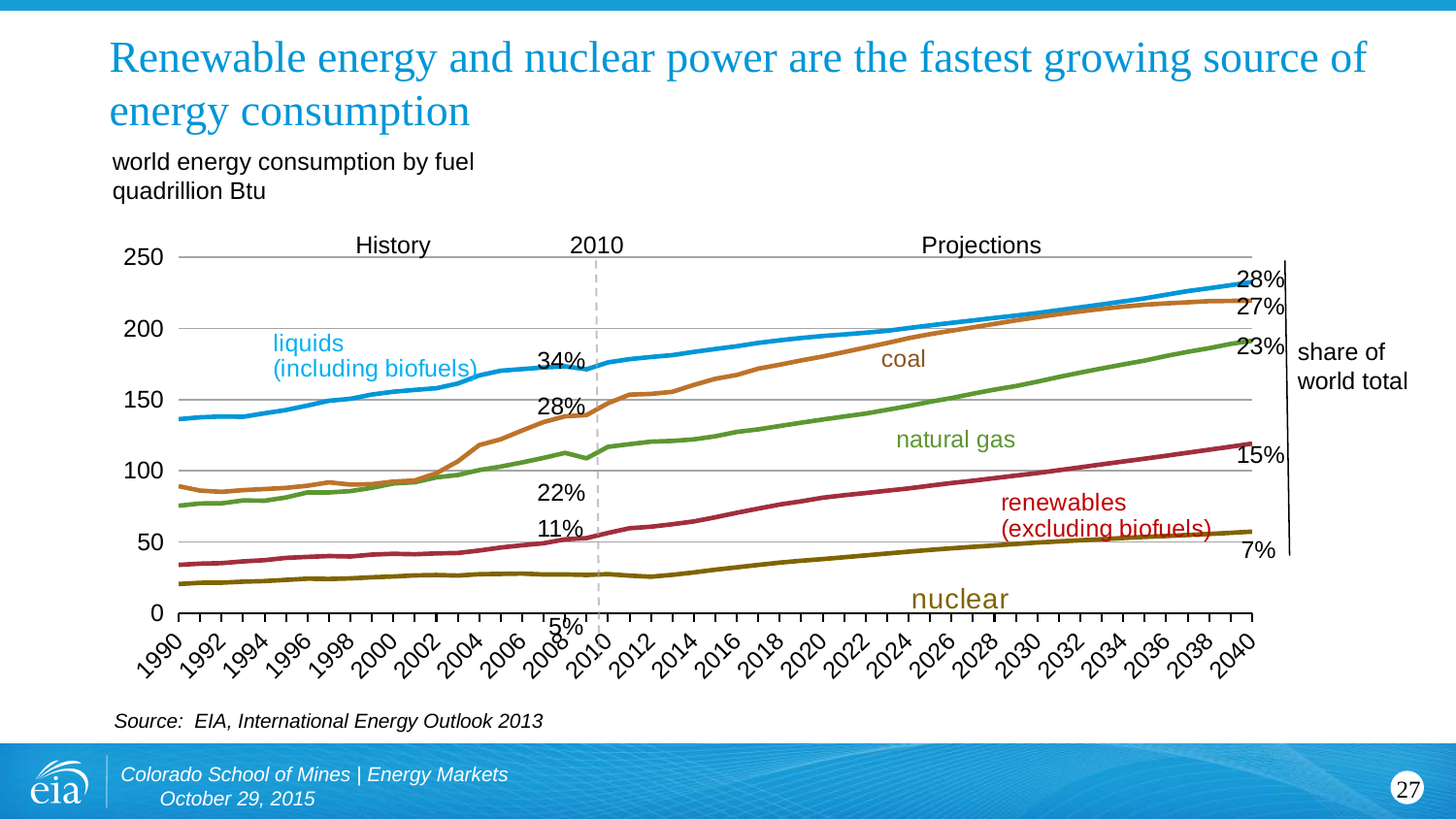
Which fuel has the lowest energy consumption across the whole period? nuclear Which fuel has the highest energy consumption in 2040? liquids (including biofuels) By how many percentage points does the share of liquids (including biofuels) change from 2010 to 2040? 6 percentage points (34% to 28%) What share of world total does natural gas have in 2040? 23% What kind of chart is shown on the slide? line chart What share of world total does liquids (including biofuels) have in 2010? 34% How many fuel series are plotted on the chart? 5 Is the value for nuclear in 2040 greater or less than 100 quadrillion Btu? less What share of world total does nuclear have in 2010? 5% Does natural gas consumption rise or fall from 1990 to 2040? rise Is the value for liquids (including biofuels) in 2040 greater or less than 200 quadrillion Btu? greater What share of world total does coal have in 2040? 27%